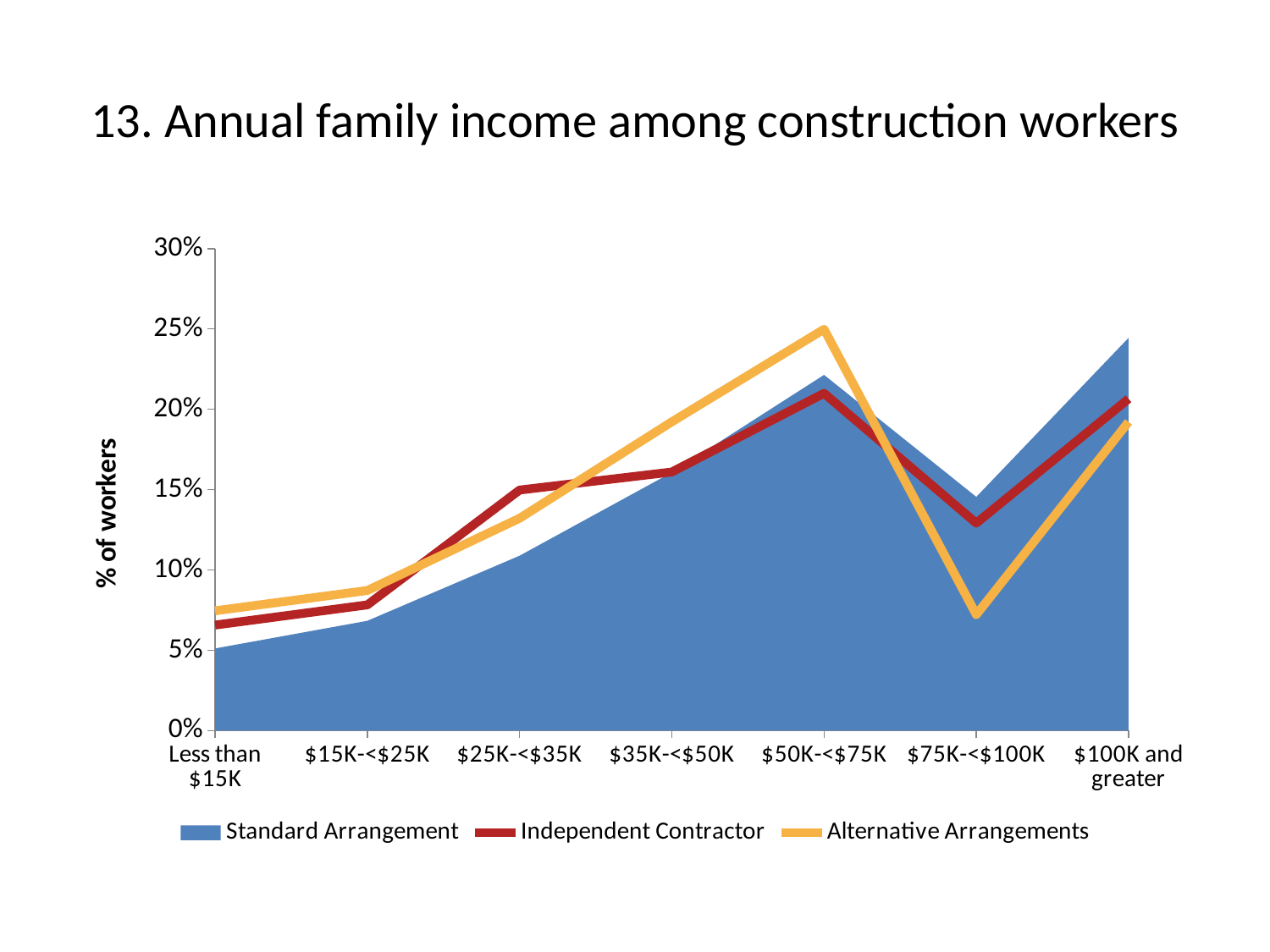
For Standard Arrangement, which income category has the highest value? $100K and greater For Alternative Arrangements, which income category has the highest value? $50K-<$75K How many series does the legend list? 3 Is the value for Standard Arrangement at $100K and greater greater or less than 20%? greater How many income categories are shown on the x axis? 7 What is the title of the y axis? % of workers Which series is drawn as a filled blue area? Standard Arrangement Is the value for Alternative Arrangements at $75K-<$100K greater or less than 10%? less For Independent Contractor, which income category has the lowest value? Less than $15K For Standard Arrangement, which income category has the lowest value? Less than $15K At $75K-<$100K, which is higher: Standard Arrangement or Alternative Arrangements? Standard Arrangement Does the Alternative Arrangements value rise or fall from $50K-<$75K to $75K-<$100K? fall